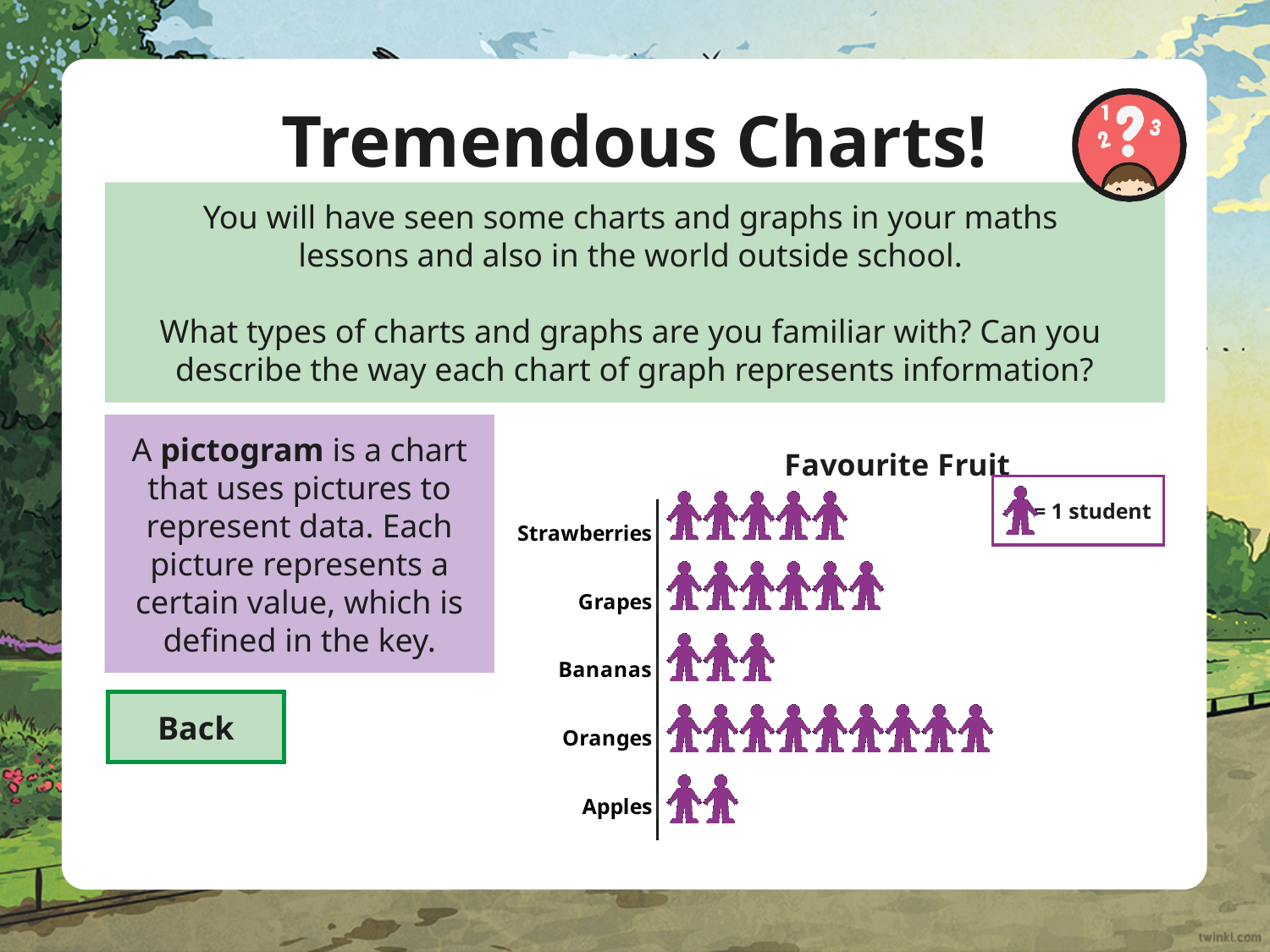
What is the title of the pictogram? Favourite Fruit According to the key, how many students does one picture represent? 1 student How many students chose Apples as their favourite fruit? 2 How many students chose Oranges as their favourite fruit? 9 Which fruit was chosen by the most students? Oranges How many students chose Grapes as their favourite fruit? 6 Which fruit was chosen by the fewest students? Apples How many more students chose Grapes than Strawberries? 1 Which was chosen by more students, Strawberries or Bananas? Strawberries How many students chose Bananas as their favourite fruit? 3 How many fruit categories are shown in the pictogram? 5 What kind of chart is shown on the slide? pictogram